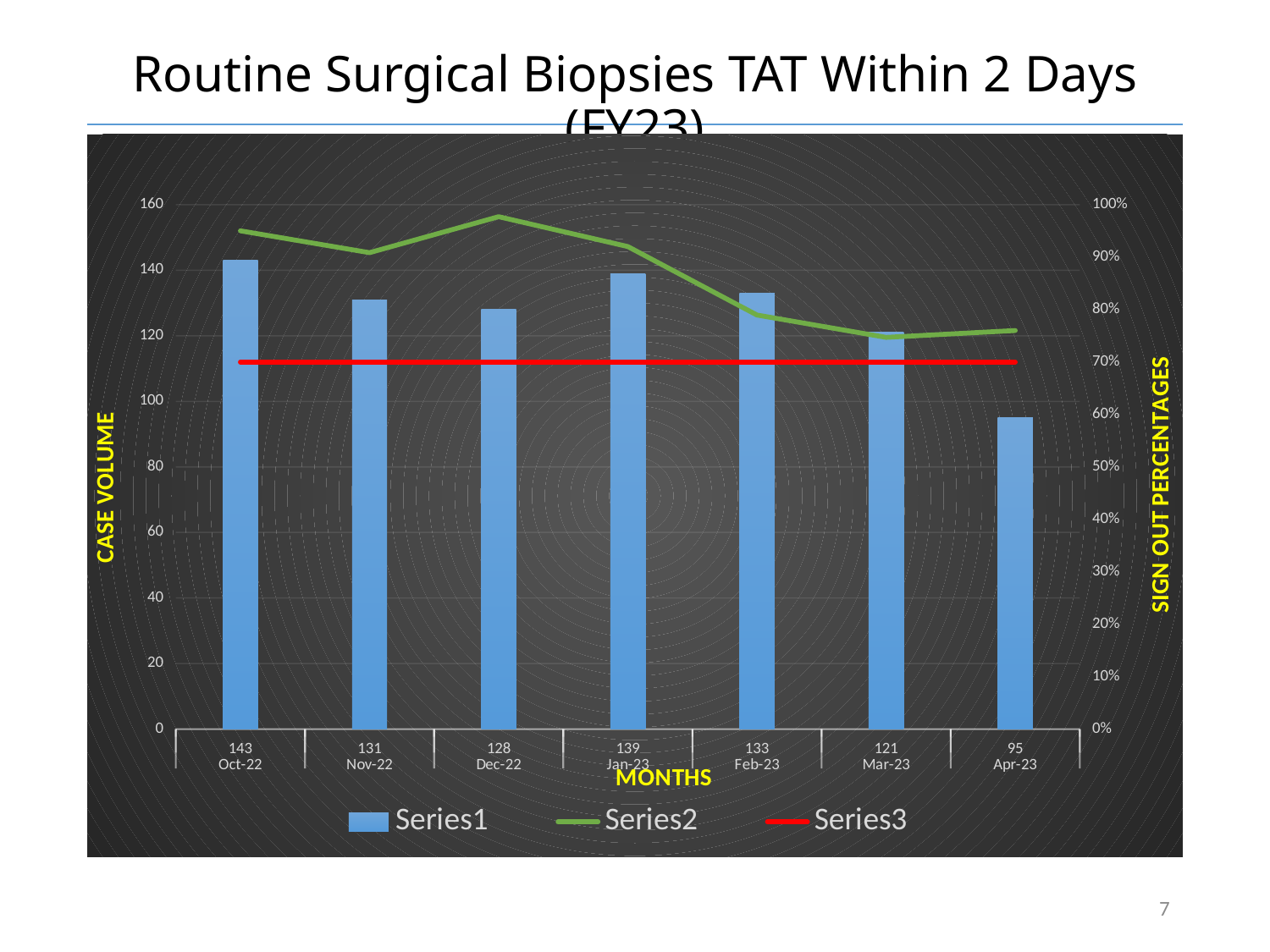
Which month has the larger case volume, Jan-23 or Feb-23? Jan-23 What is the case volume for Oct-22? 143 How many series does the legend list? 3 Is the Series2 value for Apr-23 greater or less than 80%? less What is the case volume for Apr-23? 95 Does the Series2 line rise or fall from Dec-22 to Apr-23? fall Which month has the lowest case volume? Apr-23 How many months are shown on the x axis? 7 What is the title of the left vertical axis? CASE VOLUME Which month has the highest case volume? Oct-22 What is the difference in case volume between Oct-22 and Apr-23? 48 Is the Series2 value for Oct-22 greater or less than 90%? greater